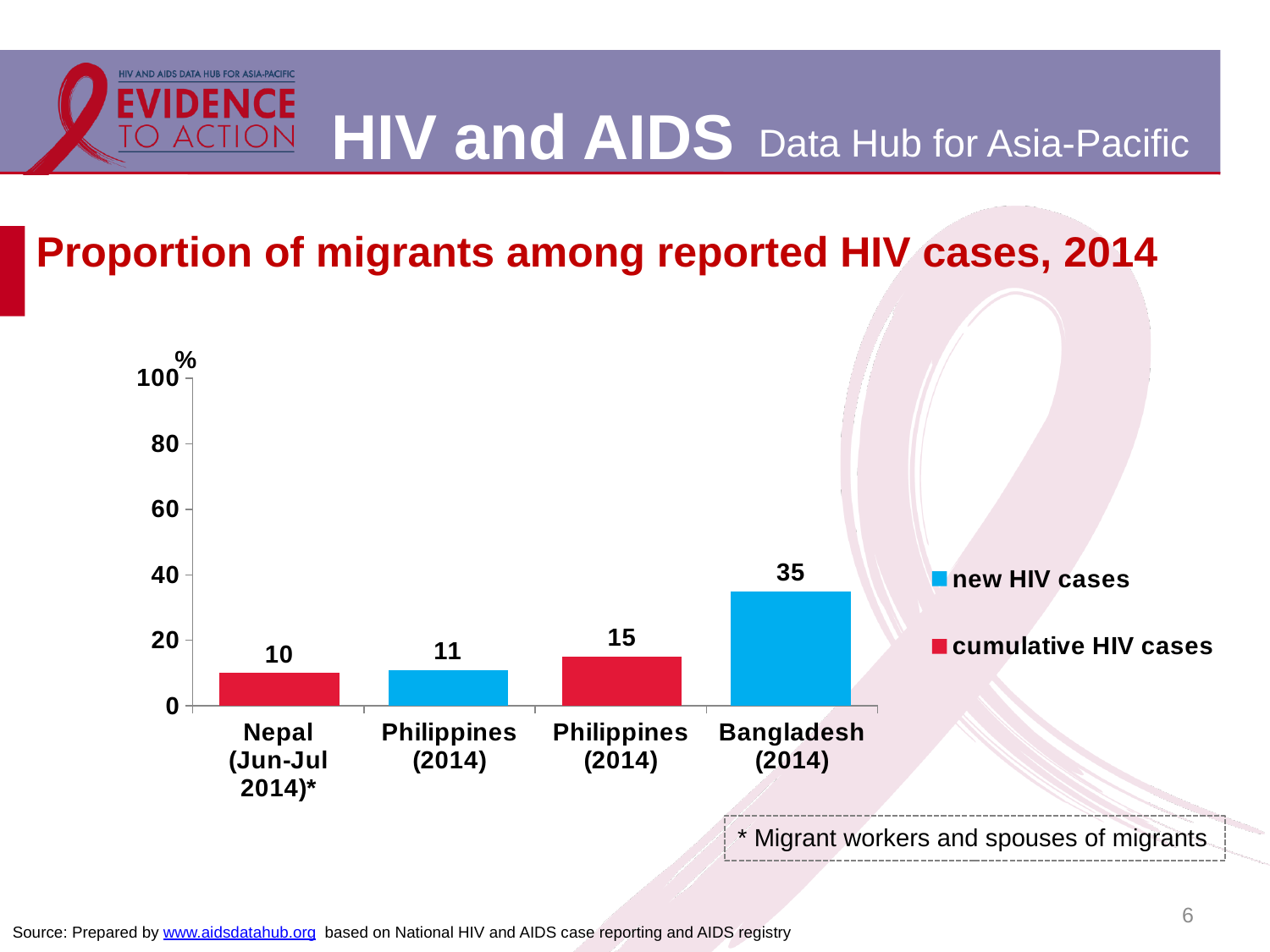
How many bars are plotted in the chart? 4 What is the value of the red (cumulative HIV cases) bar for Philippines (2014)? 15 What is the difference between the value for Bangladesh (2014) and the cumulative HIV cases value for Philippines (2014)? 20 What is the value for Nepal (Jun-Jul 2014)*? 10 How many series does the legend list? 2 Which is larger: the value for Nepal (Jun-Jul 2014)* or the new HIV cases value for Philippines (2014)? Philippines (2014) new HIV cases What is the value for Bangladesh (2014)? 35 Is the value for Bangladesh (2014) greater or less than 40? less What is the value of the blue (new HIV cases) bar for Philippines (2014)? 11 Which category has the lowest value? Nepal (Jun-Jul 2014)* Which category has the highest value? Bangladesh (2014) What kind of chart is shown on the slide? bar chart